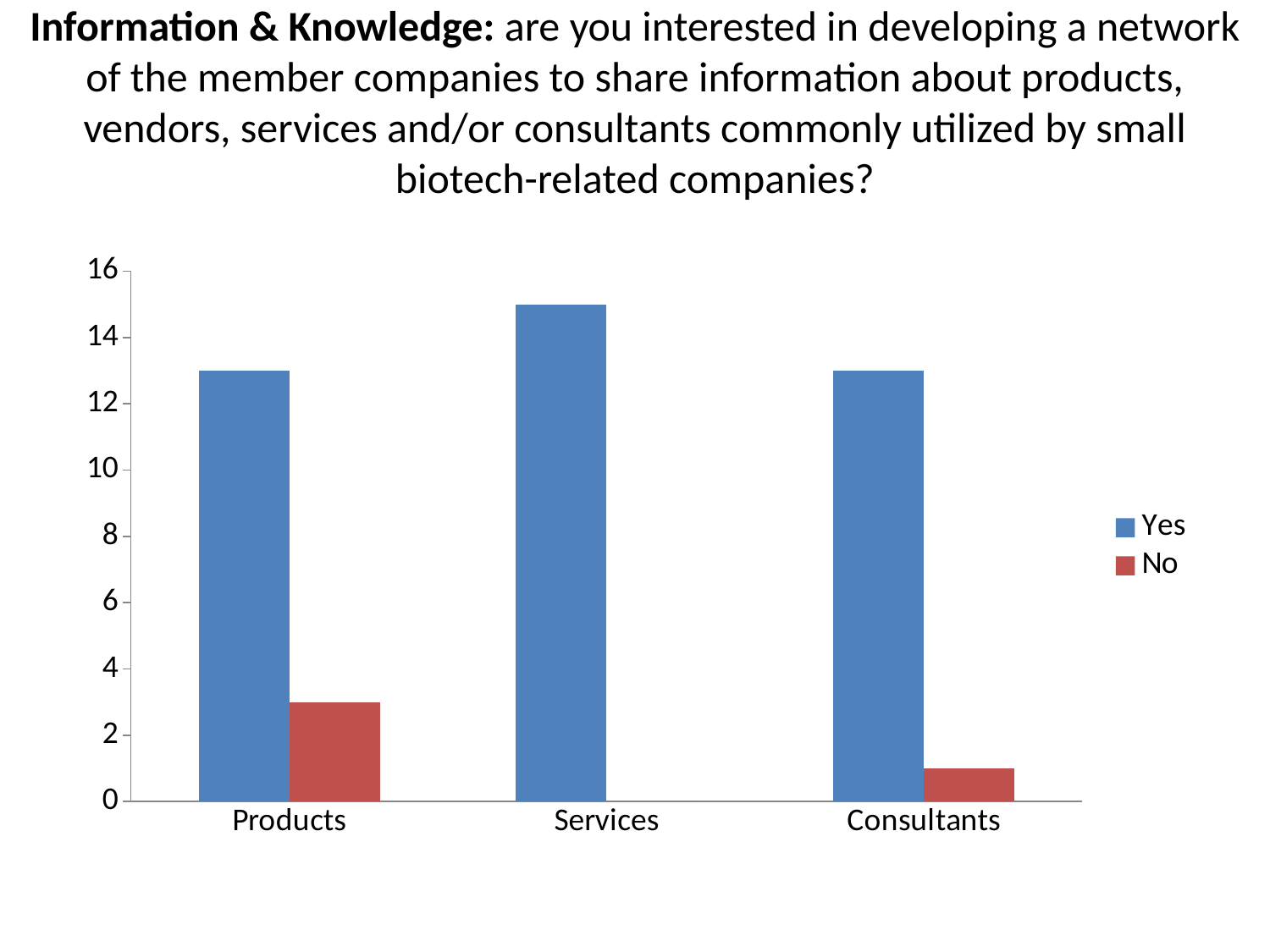
Is the No value for Consultants greater or less than 2? less How many categories are shown on the x axis? 3 Is the Yes value for Services greater or less than 14? greater What kind of chart is shown on the slide? bar chart Is the No value for Products greater or less than 2? greater Which is larger, the No value for Products or the No value for Consultants? Products Which category has the highest No value? Products How many series does the legend list? 2 Which category has the highest Yes value? Services What colour are the Yes bars? blue